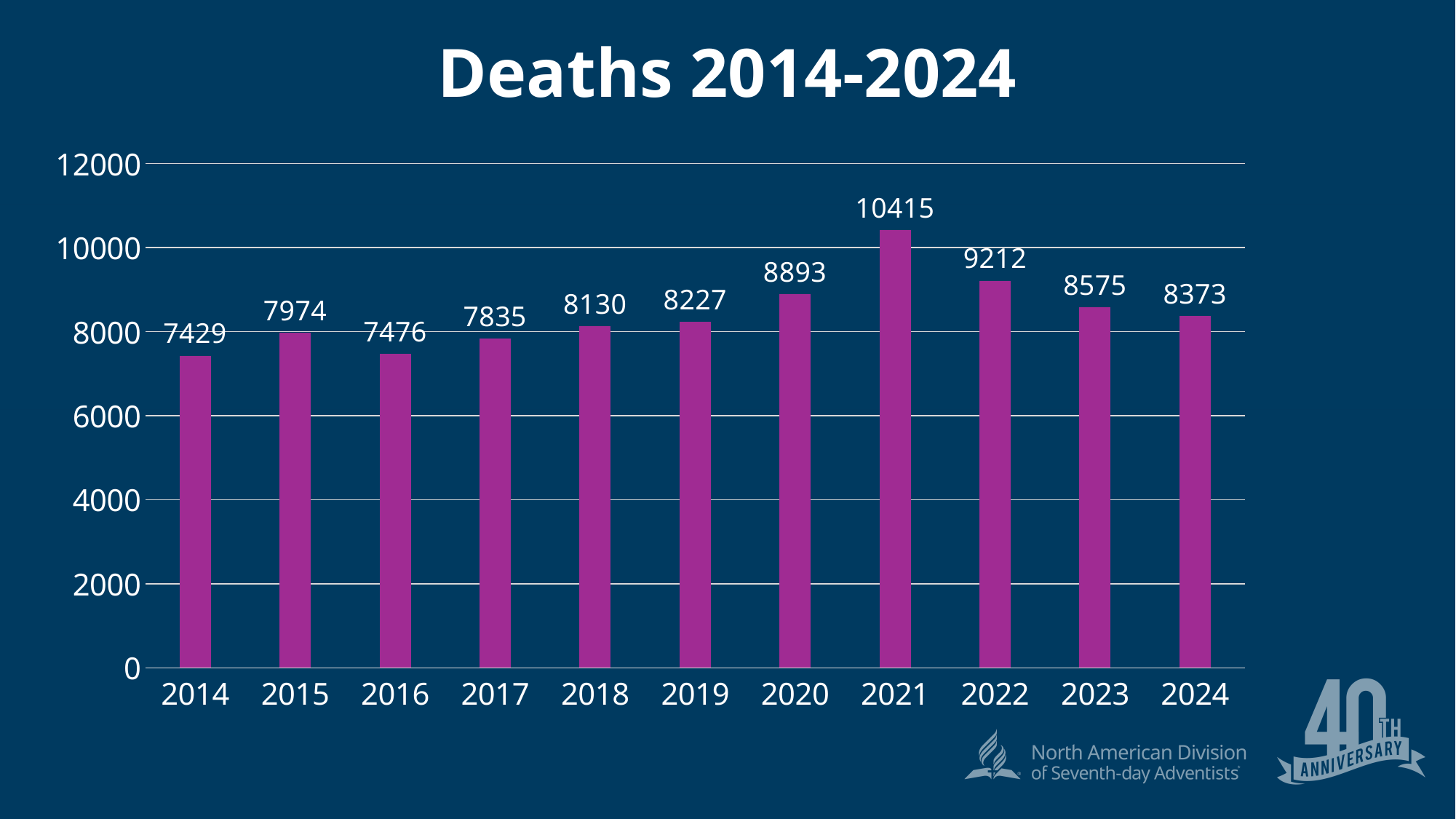
What is the difference in deaths between 2015 and 2016? 498 What is the difference in deaths between 2021 and 2022? 1203 What is the title of the chart? Deaths 2014-2024 How many years are shown on the x axis? 11 Which year has the lowest number of deaths? 2014 What is the number of deaths in 2024? 8373 What kind of chart is shown on the slide? Bar chart Is the value for 2020 greater or less than 8000? greater Which year has the highest number of deaths? 2021 What is the number of deaths in 2014? 7429 Which year had more deaths, 2018 or 2023? 2023 What is the number of deaths in 2021? 10415